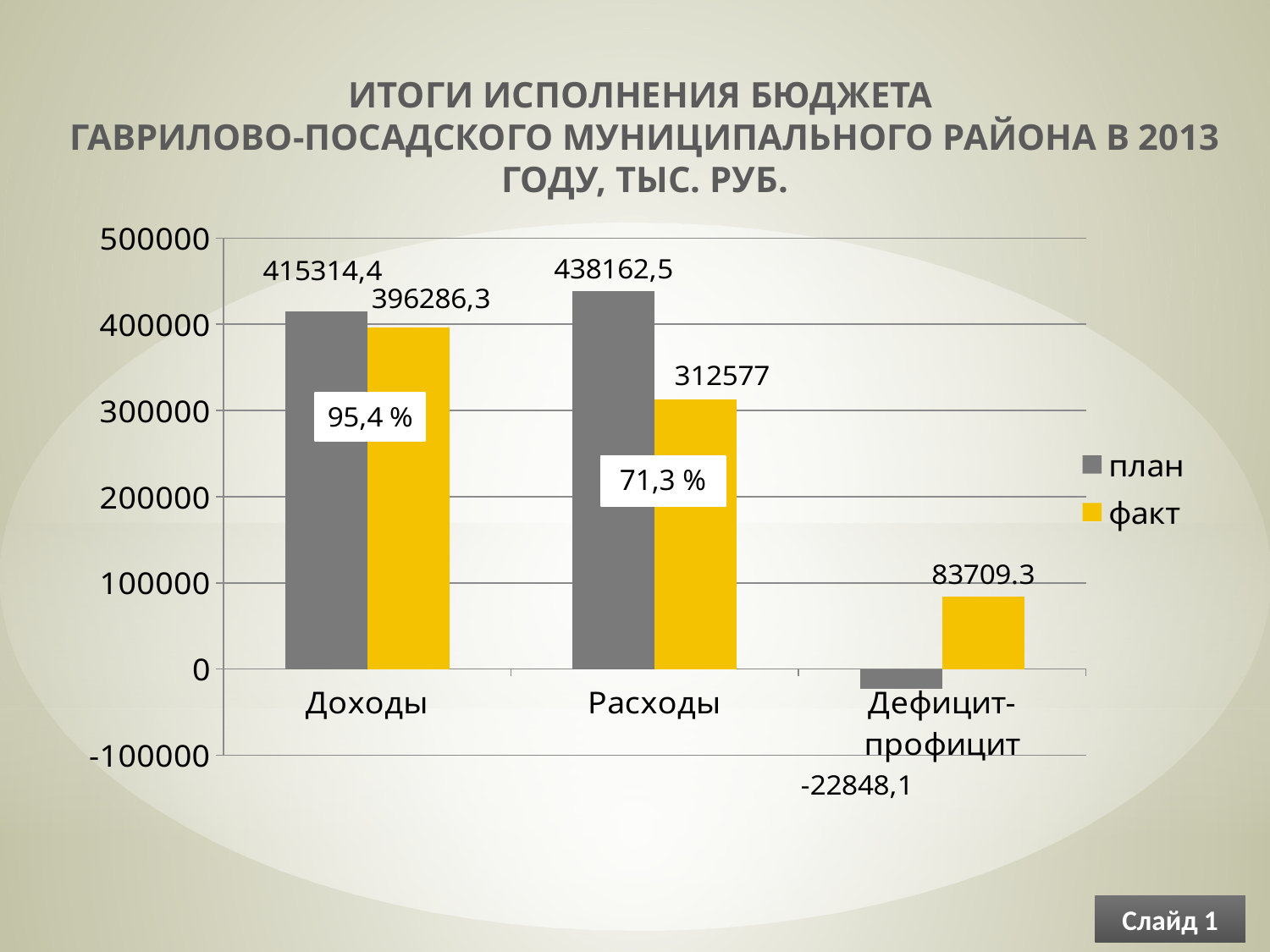
Which category has the highest план value? Расходы What percentage label is shown on the Доходы bars? 95,4 % What is the факт value for Дефицит-профицит? 83709.3 Which category has the lowest факт value? Дефицит-профицит How many series does the legend list? 2 How many categories are shown on the x axis? 3 Which is larger for Доходы: the план value or the факт value? план What is the план value for Дефицит-профицит? -22848,1 What type of chart is shown on the slide? bar chart What is the план value for Доходы? 415314,4 What is the difference between the план and факт values for Расходы? 125585,5 What is the факт value for Расходы? 312577